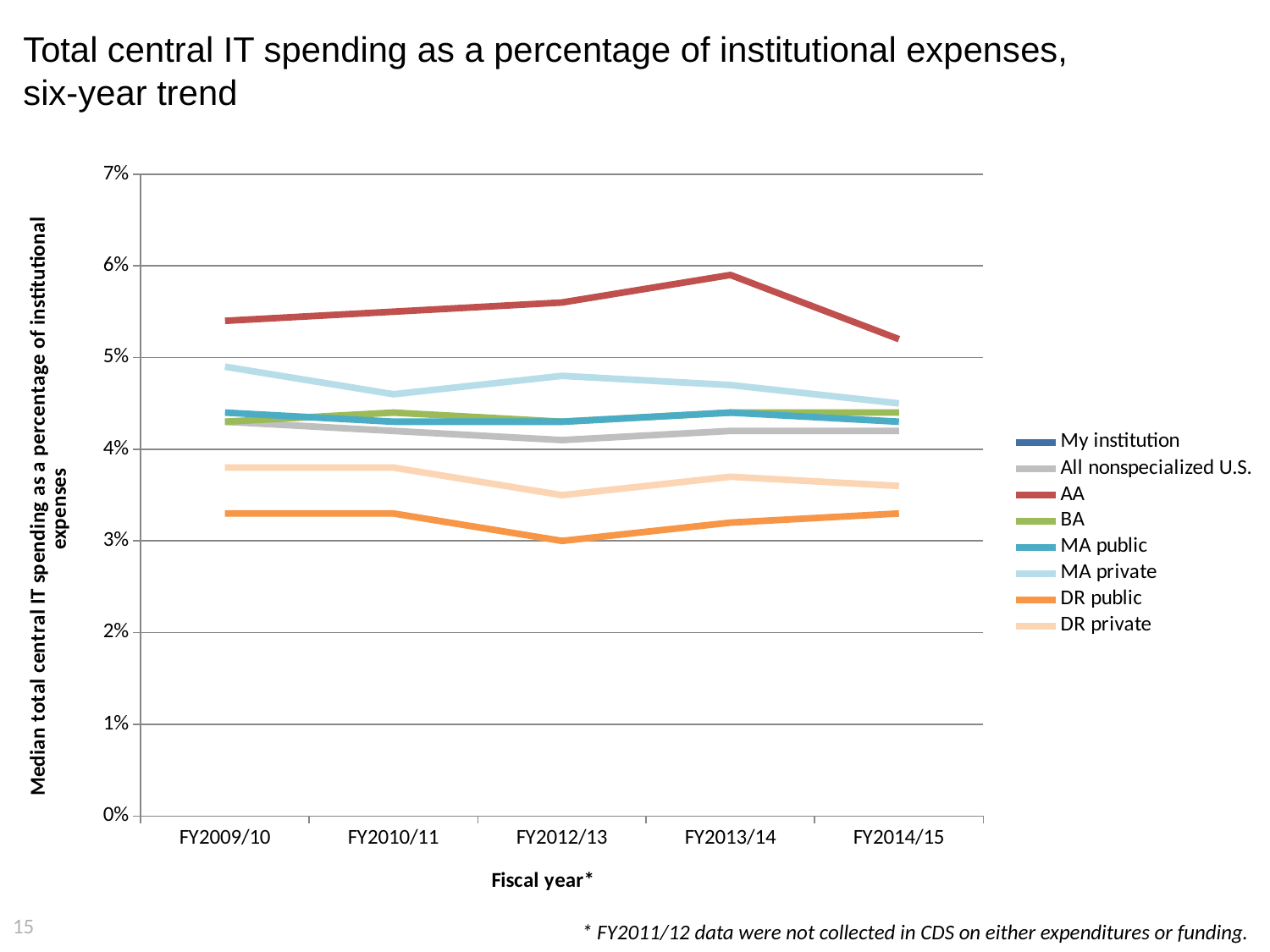
Is the value for AA in FY2013/14 greater or less than 5%? greater What is the title of the x axis? Fiscal year* How many fiscal years are plotted along the x axis? 5 Is the value for MA private in FY2009/10 greater or less than 4%? greater Does the DR public line rise or fall from FY2010/11 to FY2012/13? fall Which series has the highest value in FY2013/14? AA Is the value for DR public in FY2009/10 greater or less than 4%? less Which series has the lowest value in FY2012/13? DR public What kind of chart is shown on the slide? line chart Does the AA line rise or fall from FY2013/14 to FY2014/15? fall In FY2014/15, which is larger: the value for AA or the value for DR private? AA How many series does the legend list? 8